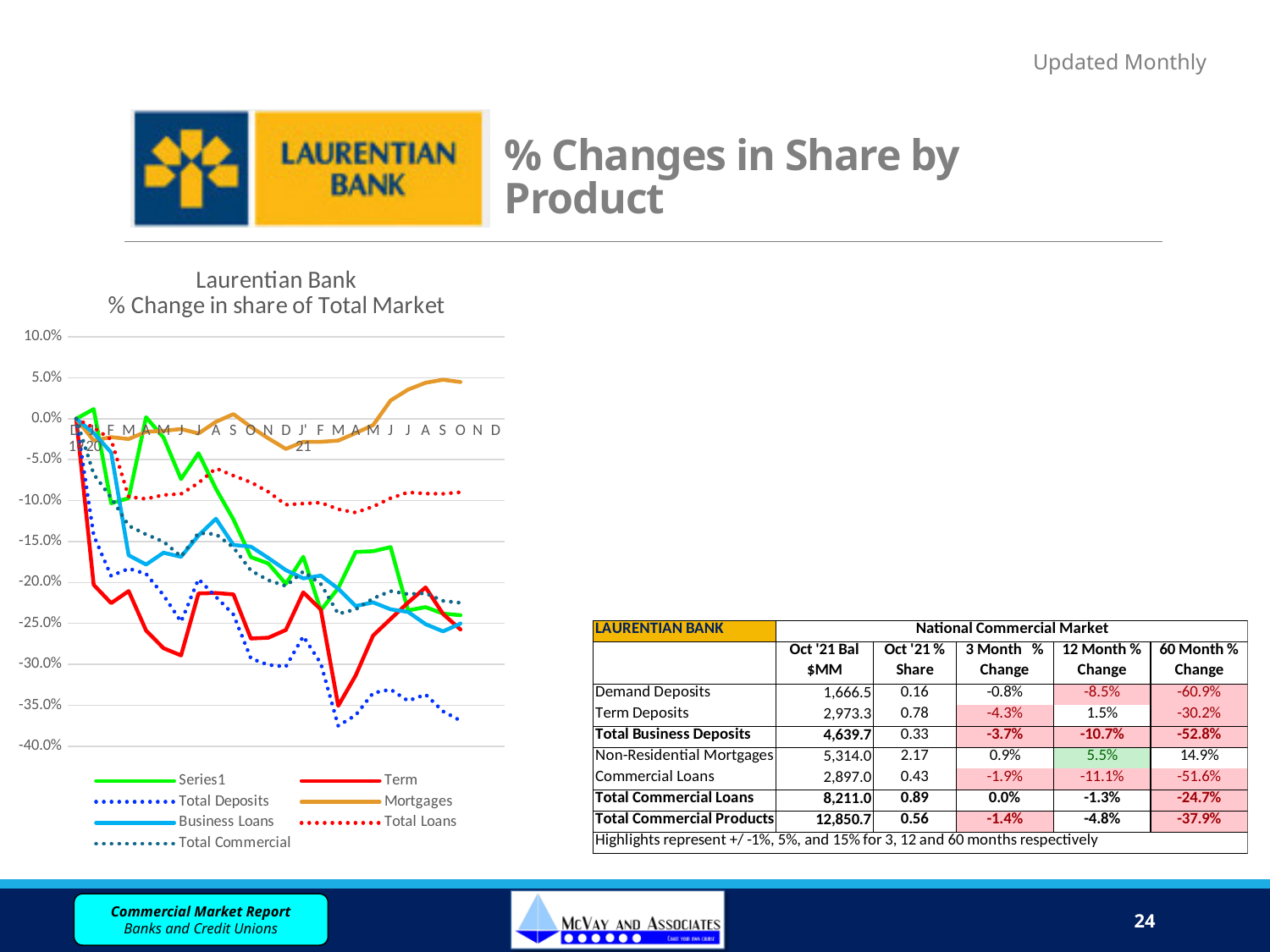
Which series has the highest value at the end of the period? Mortgages What is the title of the chart? Laurentian Bank % Change in share of Total Market Is the lowest point of the Total Deposits line greater or less than -35.0%? less Which series is drawn in orange on the chart? Mortgages At the end of the period, which is higher: Mortgages or Term? Mortgages What kind of chart is shown on the slide? Line chart How many series does the chart legend list? 7 Is the value for Total Loans at the end of the period greater or less than -5.0%? less Which series has the lowest value at the end of the period? Total Deposits Is the value for Term at the end of the period greater or less than -20.0%? less Does the Term line generally rise or fall from the start of the period to the end? Fall